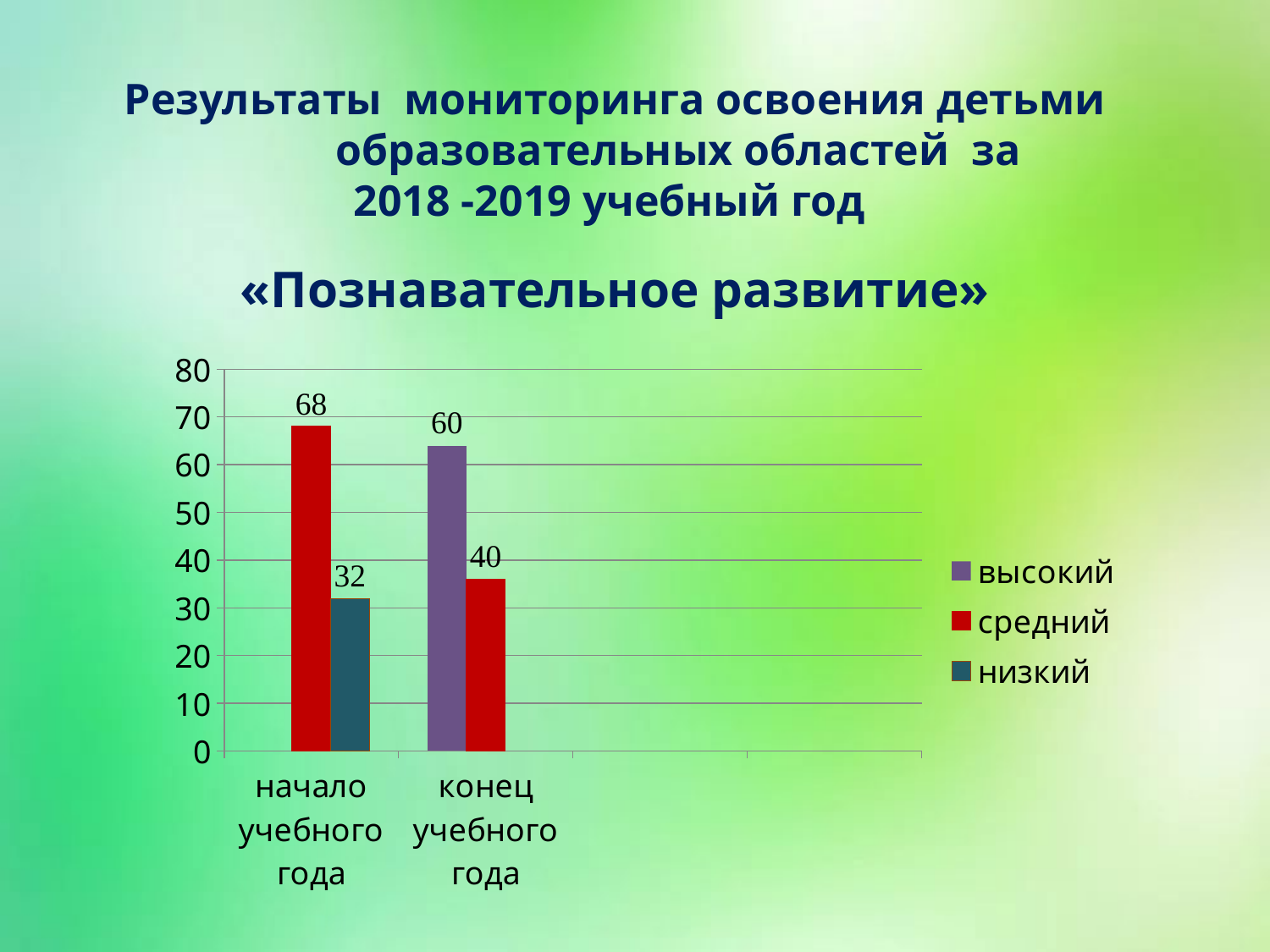
What is the value for высокий at конец учебного года? 60 Which series has the highest value at конец учебного года? высокий Does the value for средний rise or fall from начало учебного года to конец учебного года? fall How many categories are shown on the x axis? 2 Which series has the lowest value at начало учебного года? низкий What is the value for средний at конец учебного года? 40 Which is larger: высокий at конец учебного года or средний at конец учебного года? высокий at конец учебного года What kind of chart is shown on the slide? bar chart What is the value for низкий at начало учебного года? 32 What is the difference between the средний values at начало учебного года and конец учебного года? 28 How many series does the legend list? 3 What is the value for средний at начало учебного года? 68